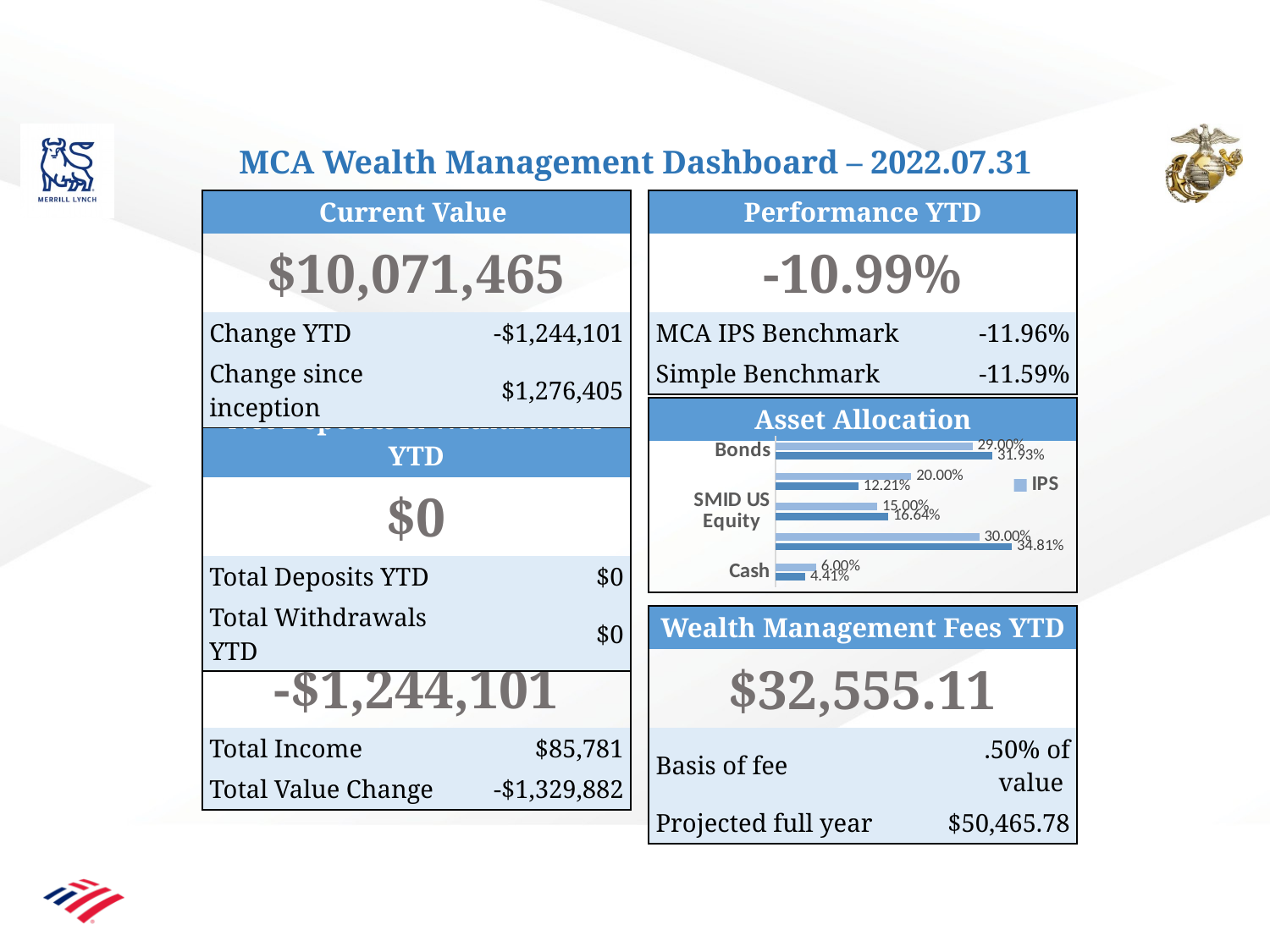
In the Asset Allocation chart, what value is shown on the darker blue bar for Cash? 4.41% In the Asset Allocation chart, what is the difference between the IPS values for Bonds and Cash? 23.00% In the Asset Allocation chart, what is the IPS value for SMID US Equity? 15.00% In the Asset Allocation chart, what is the IPS value for Bonds? 29.00% What type of chart is shown under the Asset Allocation title? bar chart How many category groups of bars are plotted in the Asset Allocation chart? 5 In the Asset Allocation chart, which is larger: the IPS value for Bonds or the IPS value for SMID US Equity? Bonds In the Asset Allocation chart, what is the difference between the two bars shown for Cash? 1.59% In the Asset Allocation chart, which category has the lowest IPS value? Cash In the Asset Allocation chart, what value is shown on the darker blue bar for Bonds? 31.93% What is the title of the chart on the slide? Asset Allocation In the Asset Allocation chart, what is the IPS value for Cash? 6.00%